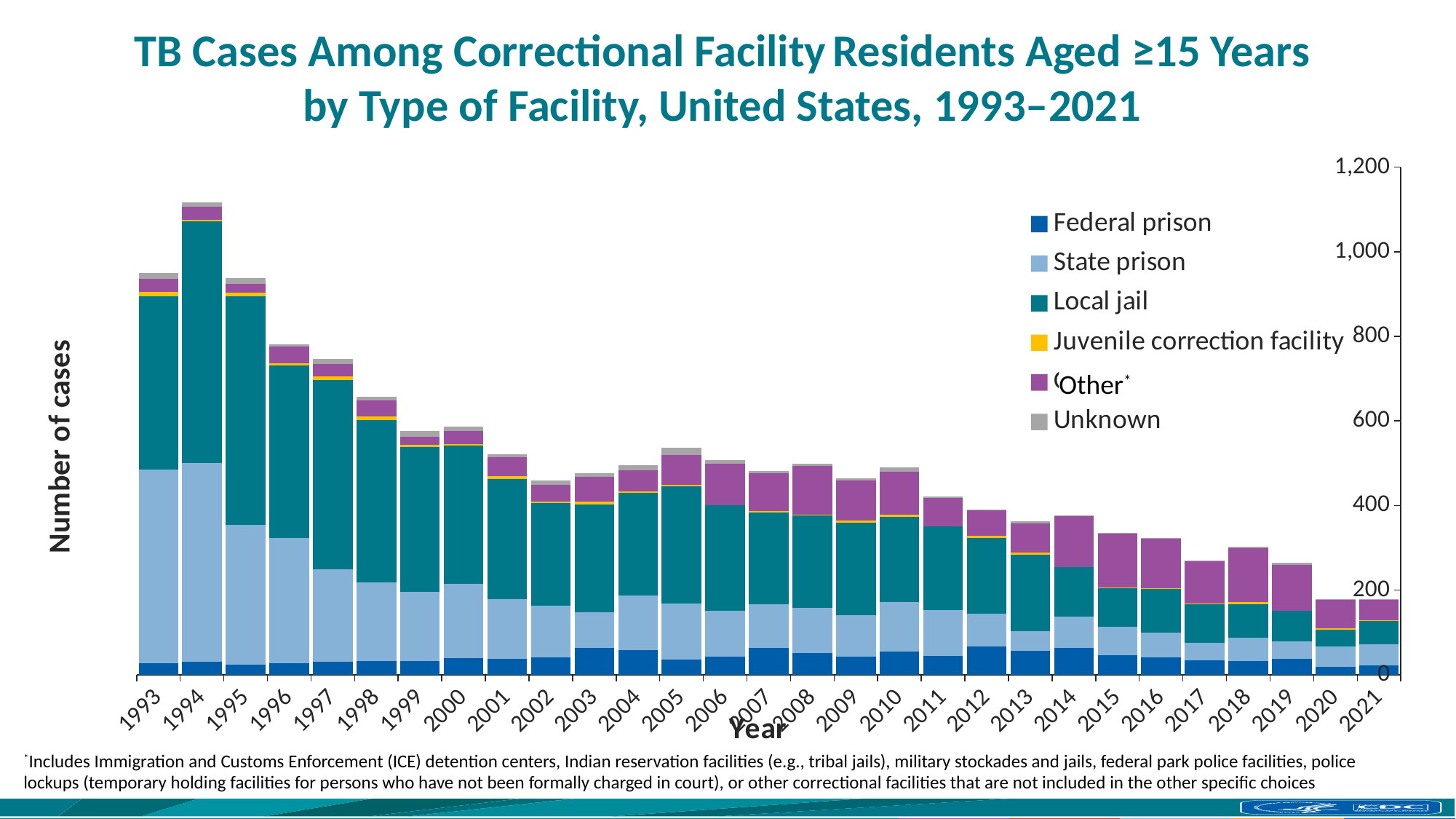
What kind of chart is shown on the slide? Stacked bar chart Is the total number of cases for 2021 greater or less than 200? less Which year has the highest total number of TB cases? 1994 What is the label on the y axis of the chart? Number of cases How many series does the legend list? 6 Is the total number of cases for 1994 greater or less than 1,000? greater How many years are shown along the x axis of the chart? 29 Which year has the larger total number of cases, 2005 or 2009? 2005 Do the total number of cases generally rise or fall from 1993 to 2021? Fall Is the total number of cases for 2013 greater or less than 400? less Which series is shown in purple in the legend? Other*